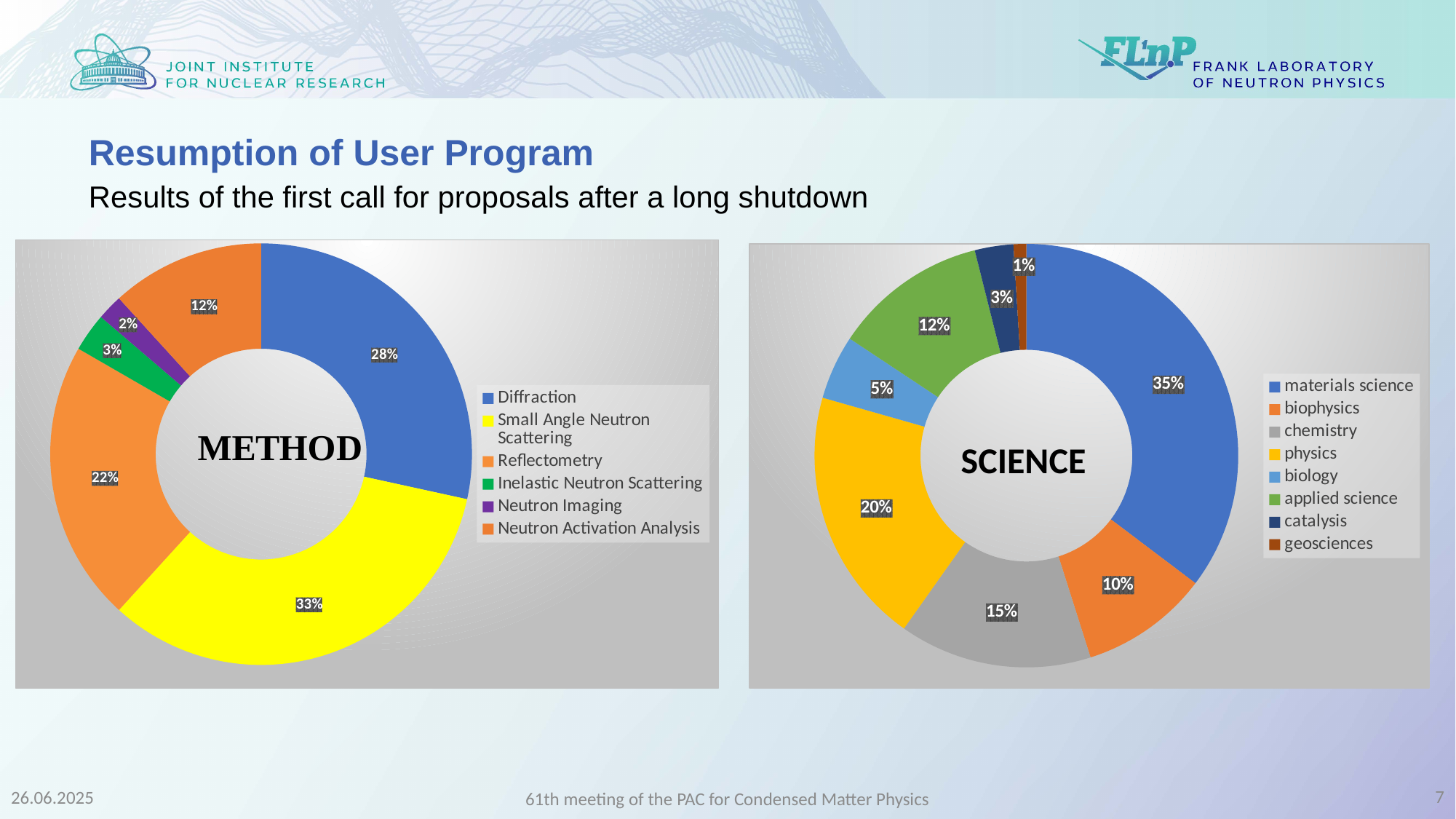
In the SCIENCE chart, what share is materials science? 35% In the METHOD chart, what share of proposals is Small Angle Neutron Scattering? 33% In the SCIENCE chart, which is larger, chemistry or biophysics? chemistry What type of chart is the SCIENCE chart? Doughnut (pie) chart In the SCIENCE chart, what percentage is shown for physics? 20% In the METHOD chart, which method has the smallest share? Neutron Imaging How many categories does the legend of the METHOD chart list? 6 In the METHOD chart, what is the difference between the Diffraction and Reflectometry shares? 6% How many categories does the legend of the SCIENCE chart list? 8 In the METHOD chart, what percentage is shown for Diffraction? 28% In the SCIENCE chart, which field has the smallest share? geosciences In the METHOD chart, which method has the largest share? Small Angle Neutron Scattering